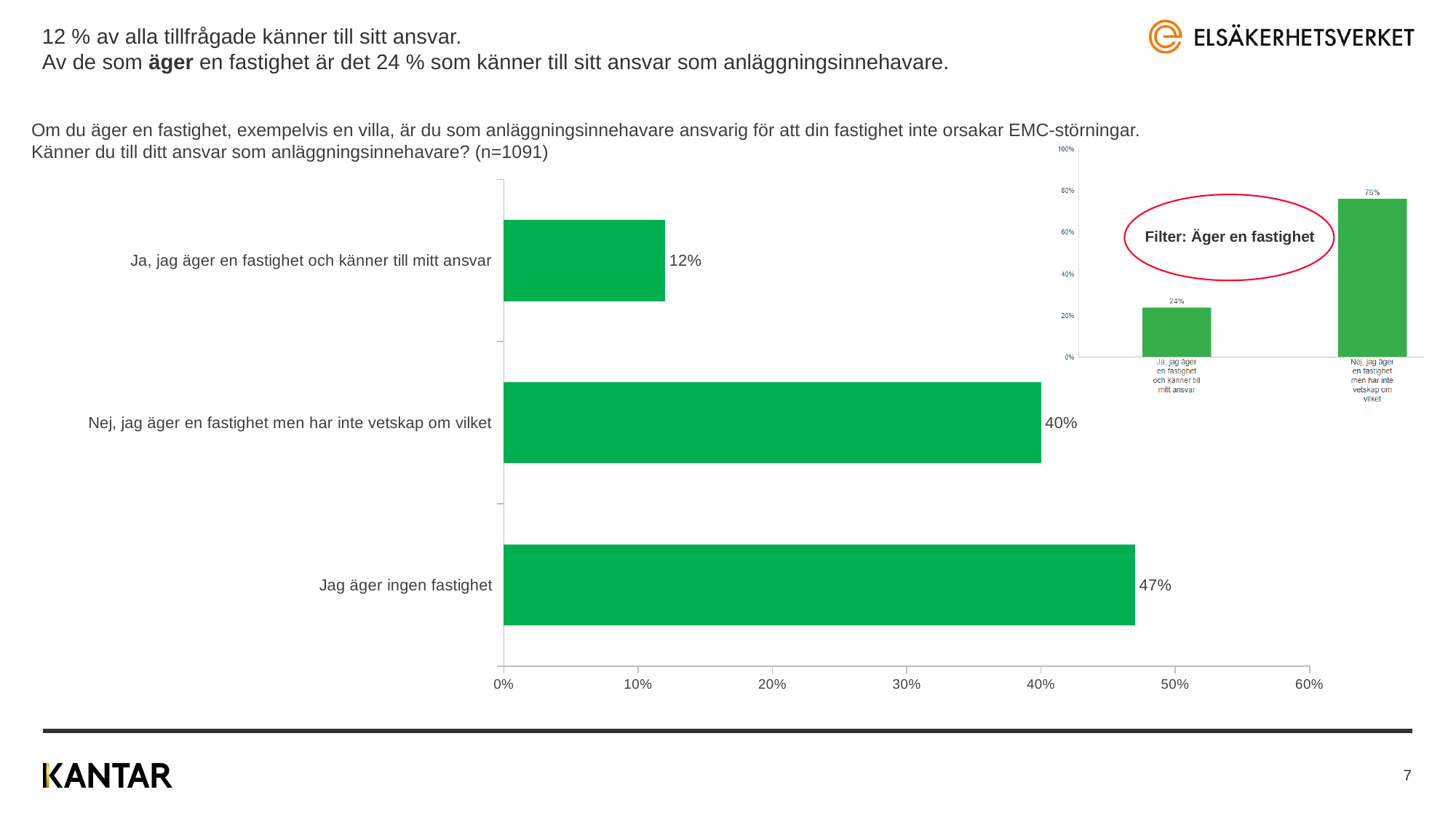
In the large horizontal bar chart, what is the value for "Nej, jag äger en fastighet men har inte vetskap om vilket"? 40% In the small chart at the top right (Filter: Äger en fastighet), what is the value for "Ja, jag äger en fastighet och känner till mitt ansvar"? 24% In the large horizontal bar chart, which category has the lowest value? Ja, jag äger en fastighet och känner till mitt ansvar In the large horizontal bar chart, which category has the highest value? Jag äger ingen fastighet In the small chart at the top right (Filter: Äger en fastighet), which of the two bars is larger? Nej, jag äger en fastighet men har inte vetskap om vilket What kind of chart is the large chart on the left of the slide? Bar chart In the large horizontal bar chart, what is the value for "Jag äger ingen fastighet"? 47% In the large horizontal bar chart, how many categories are shown? 3 In the large horizontal bar chart, what is the difference between "Jag äger ingen fastighet" and "Nej, jag äger en fastighet men har inte vetskap om vilket"? 7% In the large horizontal bar chart, what is the value for "Ja, jag äger en fastighet och känner till mitt ansvar"? 12% What filter text is shown in the red oval on the small chart at the top right? Filter: Äger en fastighet In the small chart at the top right (Filter: Äger en fastighet), what is the value for "Nej, jag äger en fastighet men har inte vetskap om vilket"? 76%